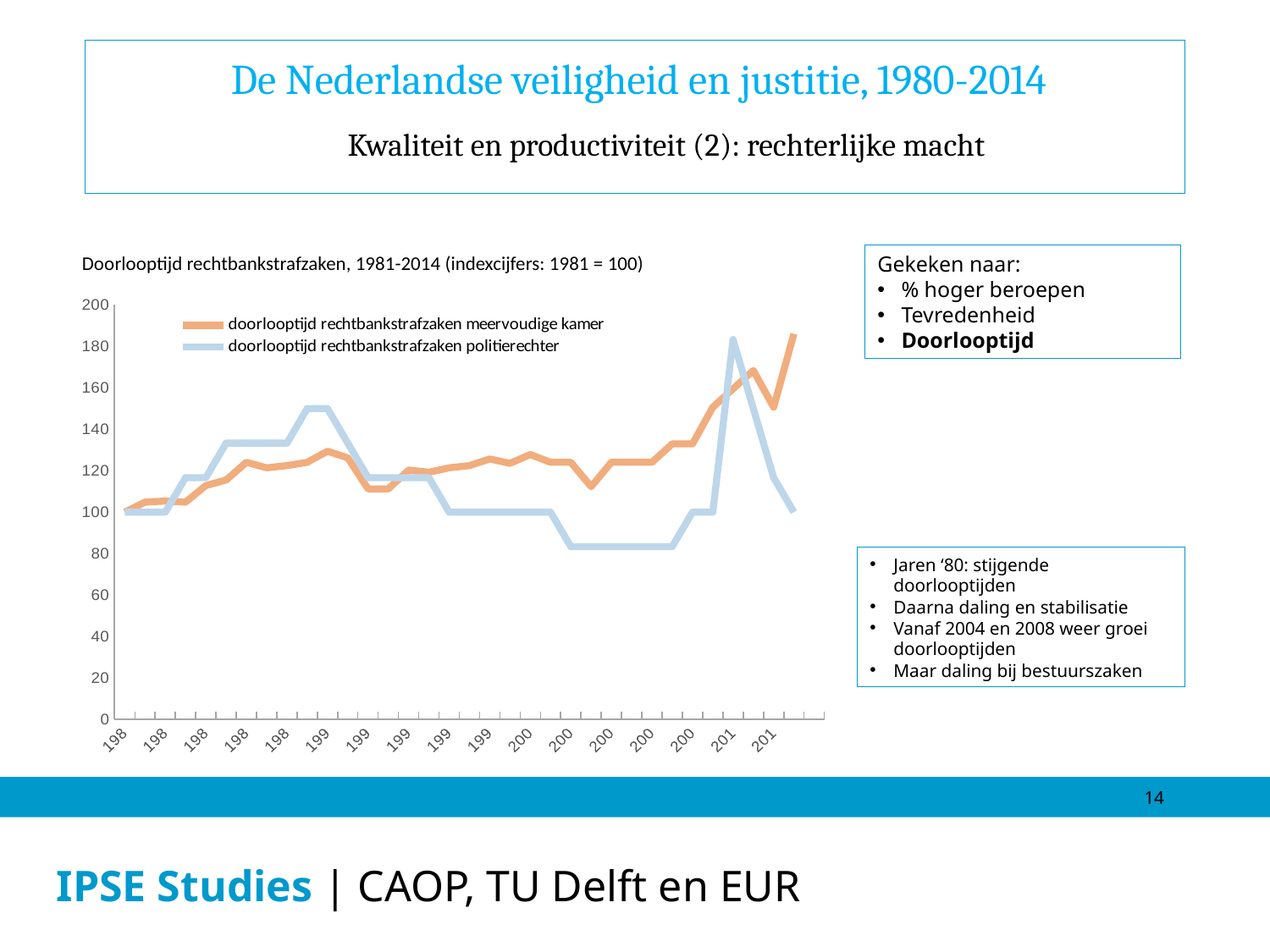
What kind of chart is shown on the slide? line chart Is the highest value of the 'doorlooptijd rechtbankstrafzaken politierechter' series greater or less than 160? greater How many series does the chart legend list? 2 After reaching its peak, does the 'doorlooptijd rechtbankstrafzaken politierechter' series rise or fall toward the end of the x axis? fall Which of the two series drops below 100 at some point in the chart? doorlooptijd rechtbankstrafzaken politierechter According to the chart title, what is the index value for the base year 1981? 100 Is the final value of the 'doorlooptijd rechtbankstrafzaken meervoudige kamer' series greater or less than 160? greater What is the maximum value shown on the y axis? 200 Is the lowest value of the 'doorlooptijd rechtbankstrafzaken politierechter' series greater or less than 100? less What is the title of the chart? Doorlooptijd rechtbankstrafzaken, 1981-2014 (indexcijfers: 1981 = 100) Which series is drawn in orange? doorlooptijd rechtbankstrafzaken meervoudige kamer